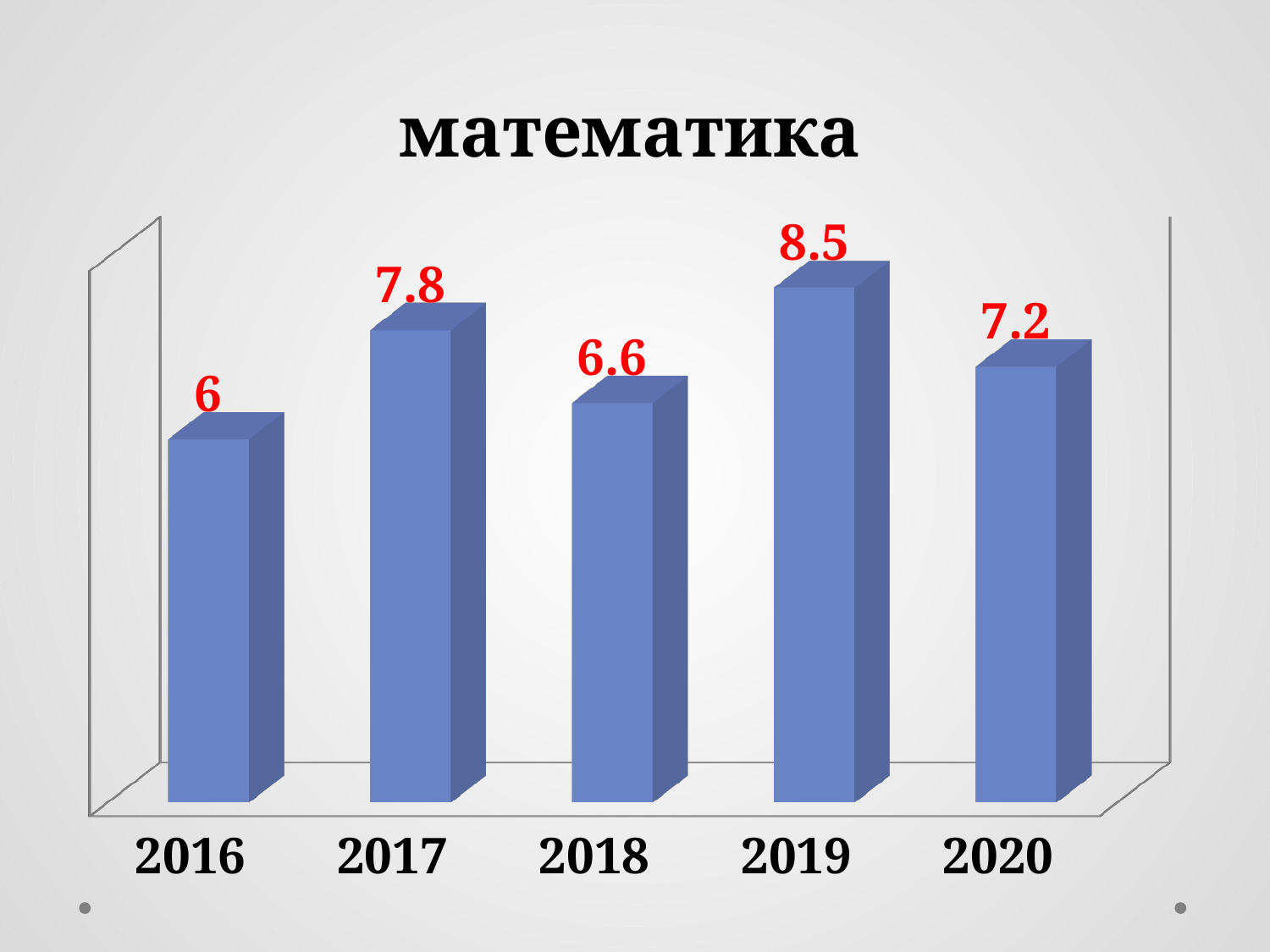
Which year has the highest value? 2019 What is the value for 2016? 6 What is the difference between the values for 2019 and 2016? 2.5 What is the title of the chart? математика What is the difference between the values for 2017 and 2018? 1.2 What is the value for 2019? 8.5 How many years are shown on the chart? 5 Which year has the lowest value? 2016 What is the value for 2020? 7.2 Which is larger, the value for 2017 or the value for 2020? 2017 What kind of chart is this? bar chart Does the value rise or fall from 2019 to 2020? fall